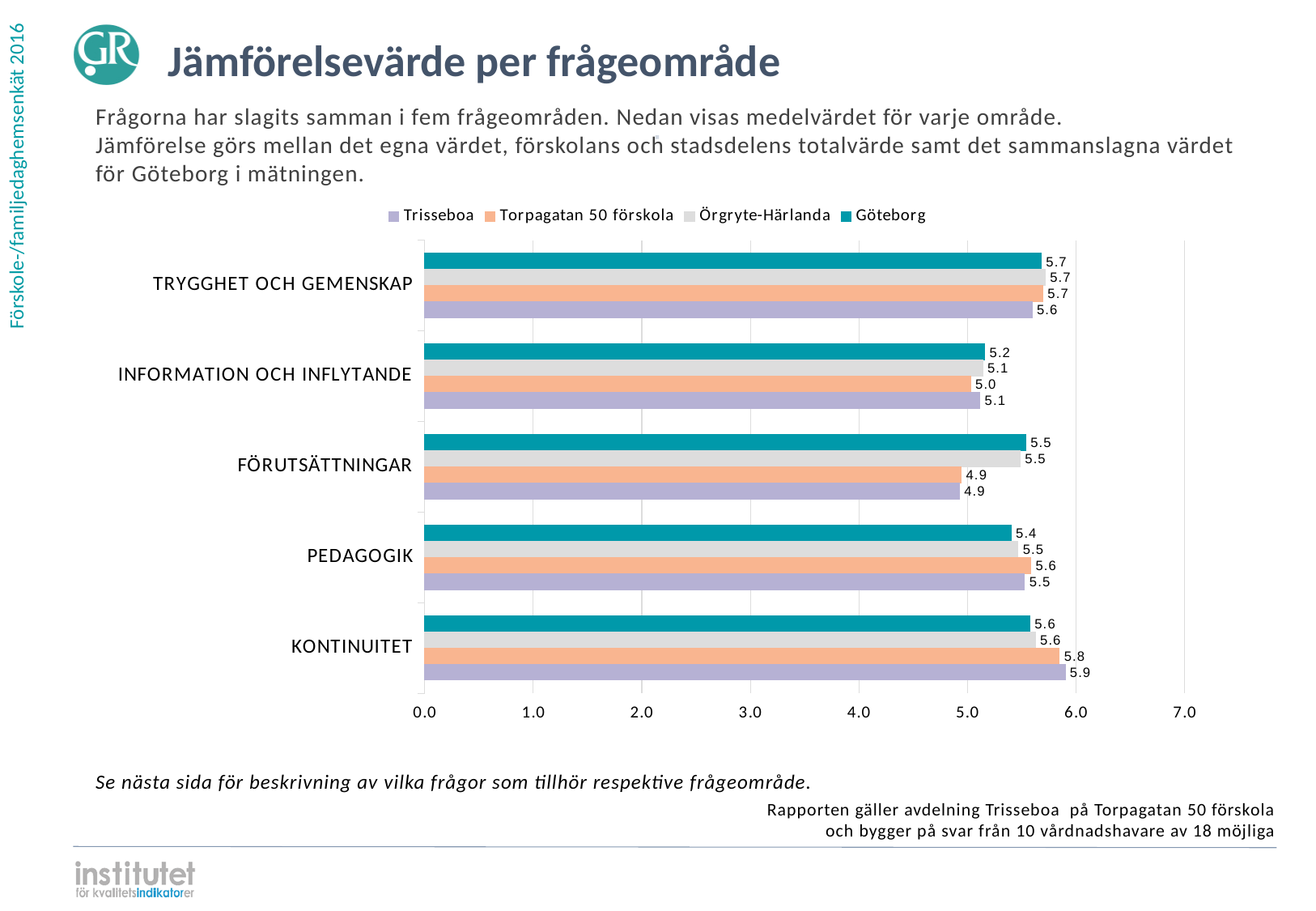
What is the value for Örgryte-Härlanda in the PEDAGOGIK category? 5.5 What is the value for Torpagatan 50 förskola in the FÖRUTSÄTTNINGAR category? 4.9 How many categories are shown on the y axis of the chart? 5 How many series does the legend list? 4 In which category does Trisseboa have its highest value? KONTINUITET In the KONTINUITET category, which is larger: the Trisseboa value or the Göteborg value? Trisseboa What is the difference between the Göteborg value and the Trisseboa value in the FÖRUTSÄTTNINGAR category? 0.6 What is the maximum value shown on the x axis of the chart? 7.0 What is the value for Göteborg in the INFORMATION OCH INFLYTANDE category? 5.2 What kind of chart is shown on the slide? Bar chart In which category does Trisseboa have its lowest value? FÖRUTSÄTTNINGAR What is the value for Trisseboa in the KONTINUITET category? 5.9